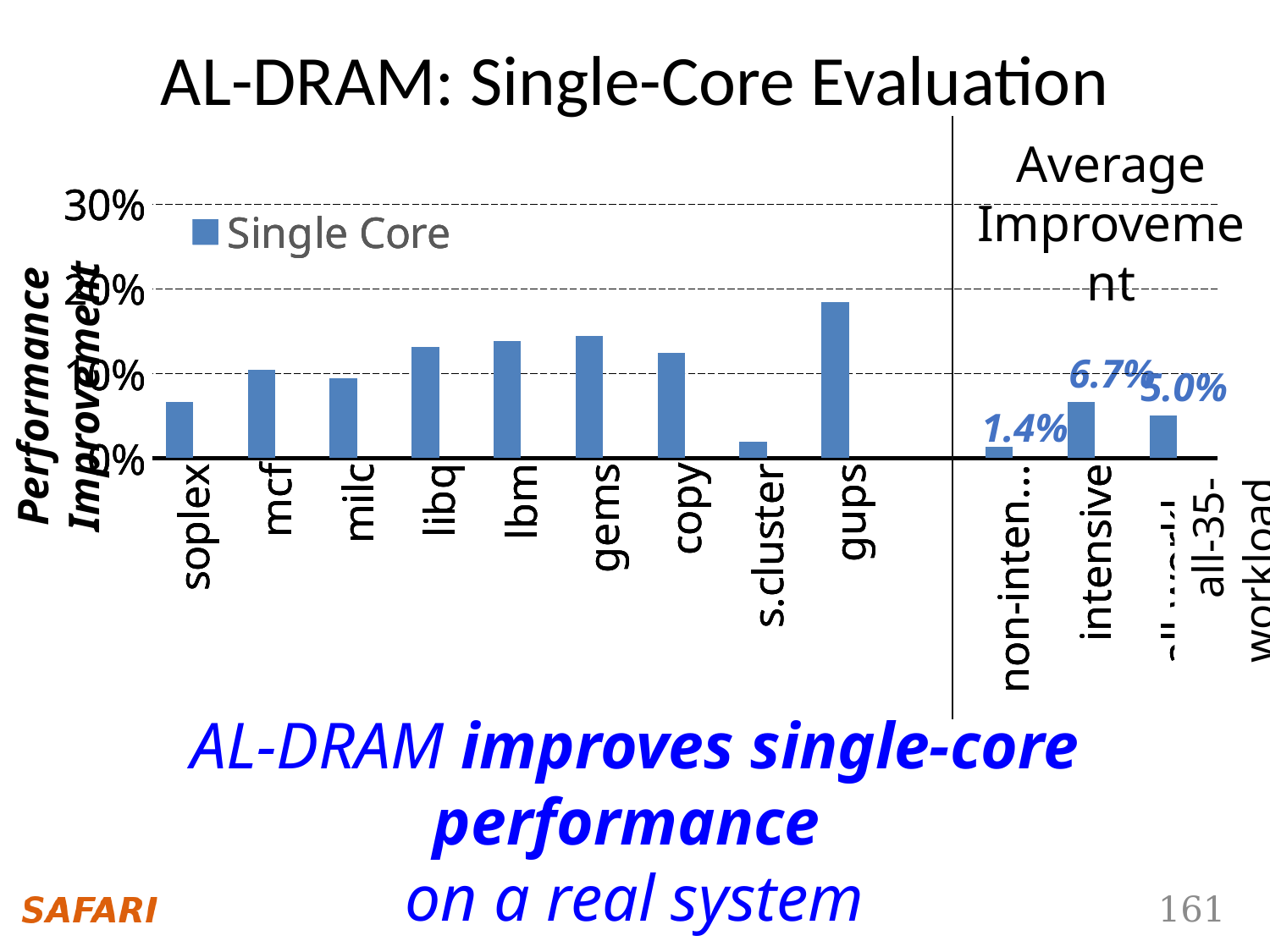
What is the data label shown for the intensive category? 6.7% What type of chart is shown on the slide? bar chart Is the value for gups greater or less than 20%? less What is the data label shown for the non-intensive category? 1.4% Which of the individual benchmark workloads (soplex through gups) has the lowest performance improvement? s.cluster Which has a larger average improvement, intensive or non-intensive? intensive Is the value for libq greater or less than 10%? greater Which of the individual benchmark workloads (soplex through gups) has the highest performance improvement? gups What is the data label shown on the rightmost bar (all-35-workload)? 5.0% Is the value for soplex greater or less than 10%? less What is the difference between the intensive and non-intensive average improvements? 5.3% How many series does the legend list? 1